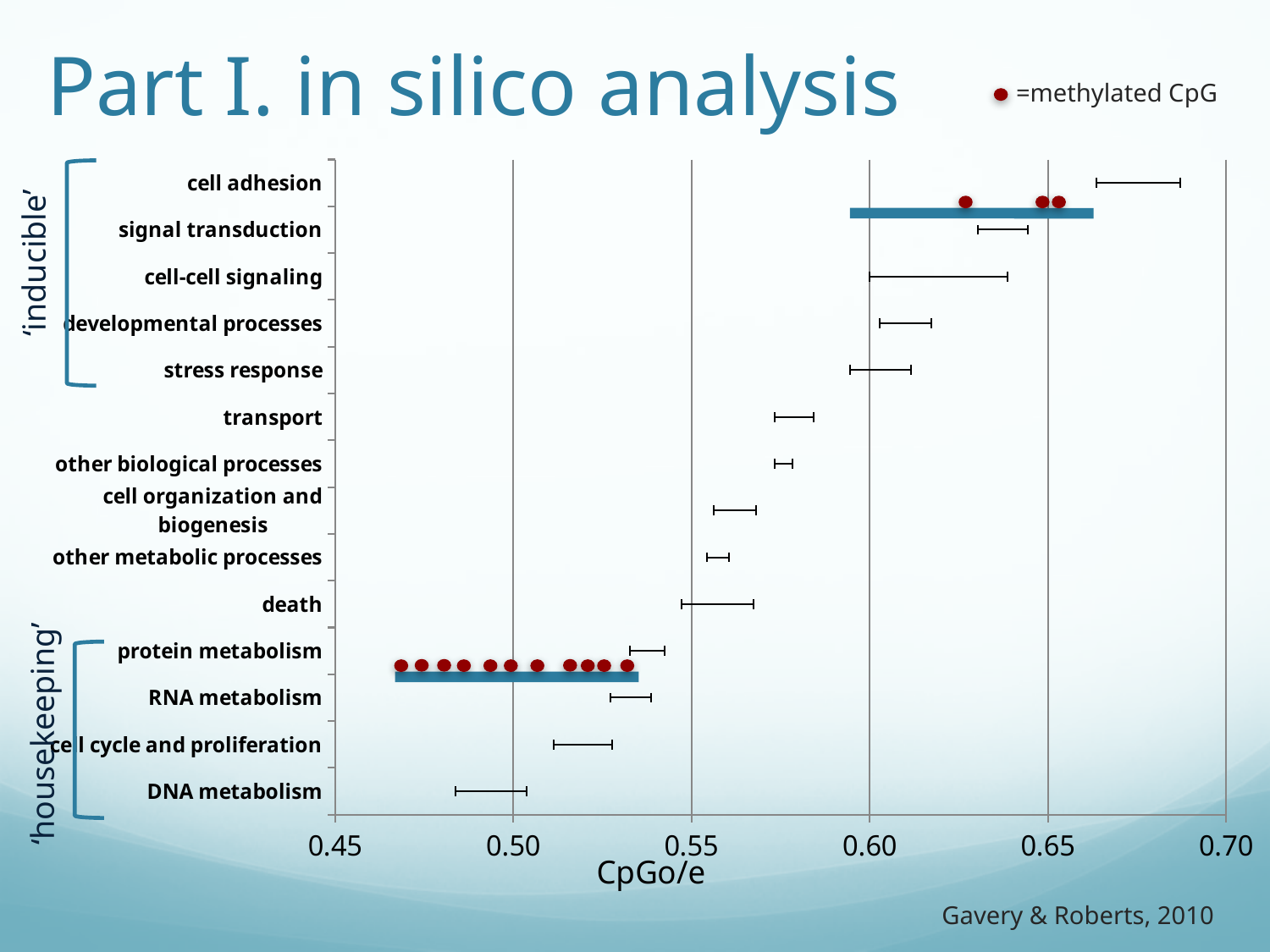
Which has a higher CpGo/e value, cell adhesion or DNA metabolism? cell adhesion Is the CpGo/e value for DNA metabolism greater or less than 0.55? less Is the CpGo/e value for transport greater or less than 0.55? greater What is the label of the x axis of the chart? CpGo/e Which category has the highest CpGo/e range on the chart? cell adhesion Is the CpGo/e value for RNA metabolism greater or less than 0.55? less How many categories are listed on the y axis of the chart? 14 Which category has the lowest CpGo/e range on the chart? DNA metabolism Which has a higher CpGo/e value, transport or death? transport Do the CpGo/e values rise or fall moving down the category list from cell adhesion to DNA metabolism? fall